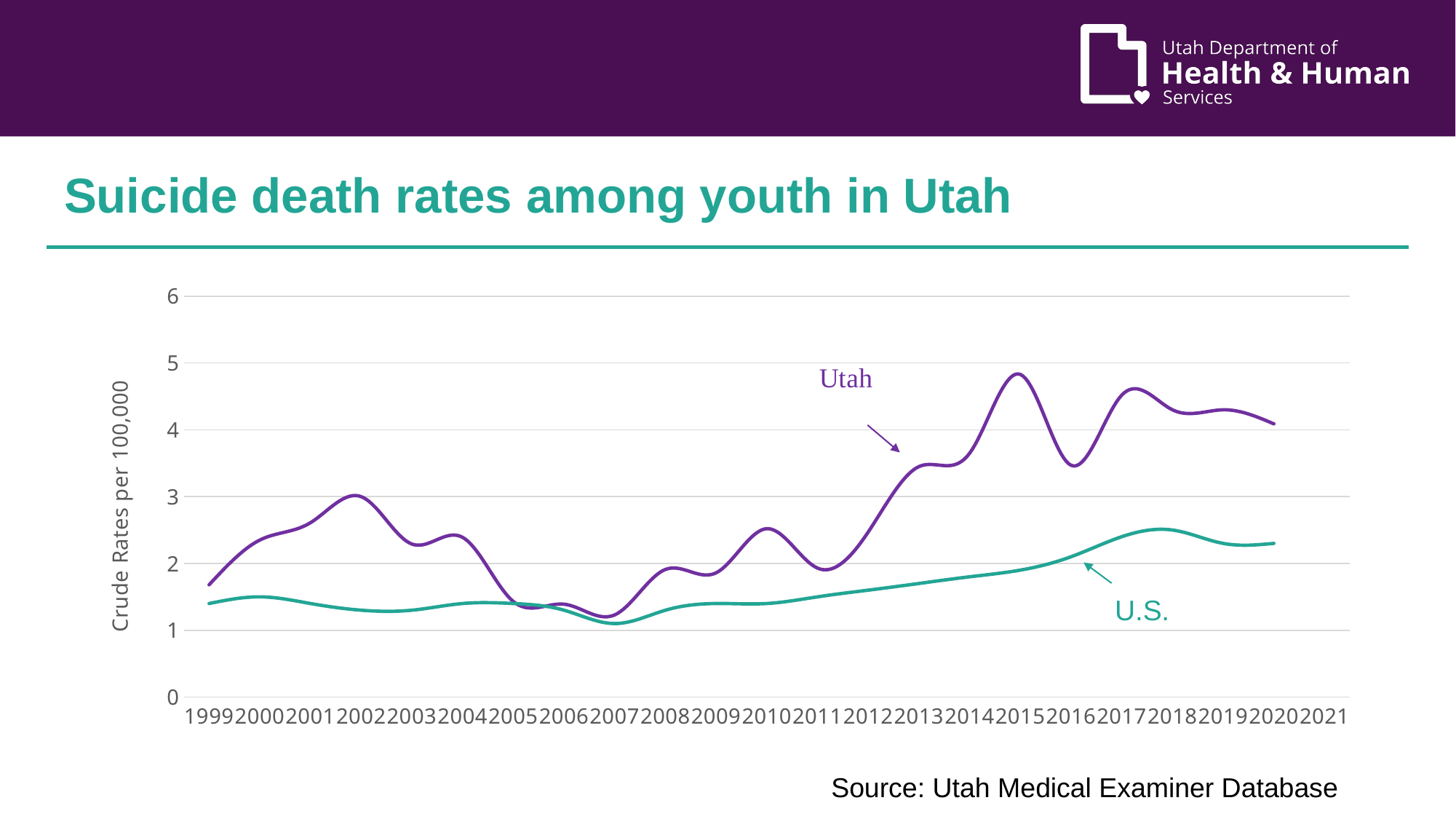
In which year does the Utah line reach its highest value? 2015 Is the value for Utah in 2013 greater or less than 3? greater How many years are shown along the x axis of the chart? 23 Is the value for Utah in 1999 greater or less than 2? less How many series are plotted on the chart? 2 In which year does the U.S. line reach its lowest value? 2007 Does the U.S. line rise or fall between 2007 and 2018? rise What kind of chart is shown on the slide? line chart Is the value for Utah in 2015 greater or less than 4? greater What is the label on the y axis of the chart? Crude Rates per 100,000